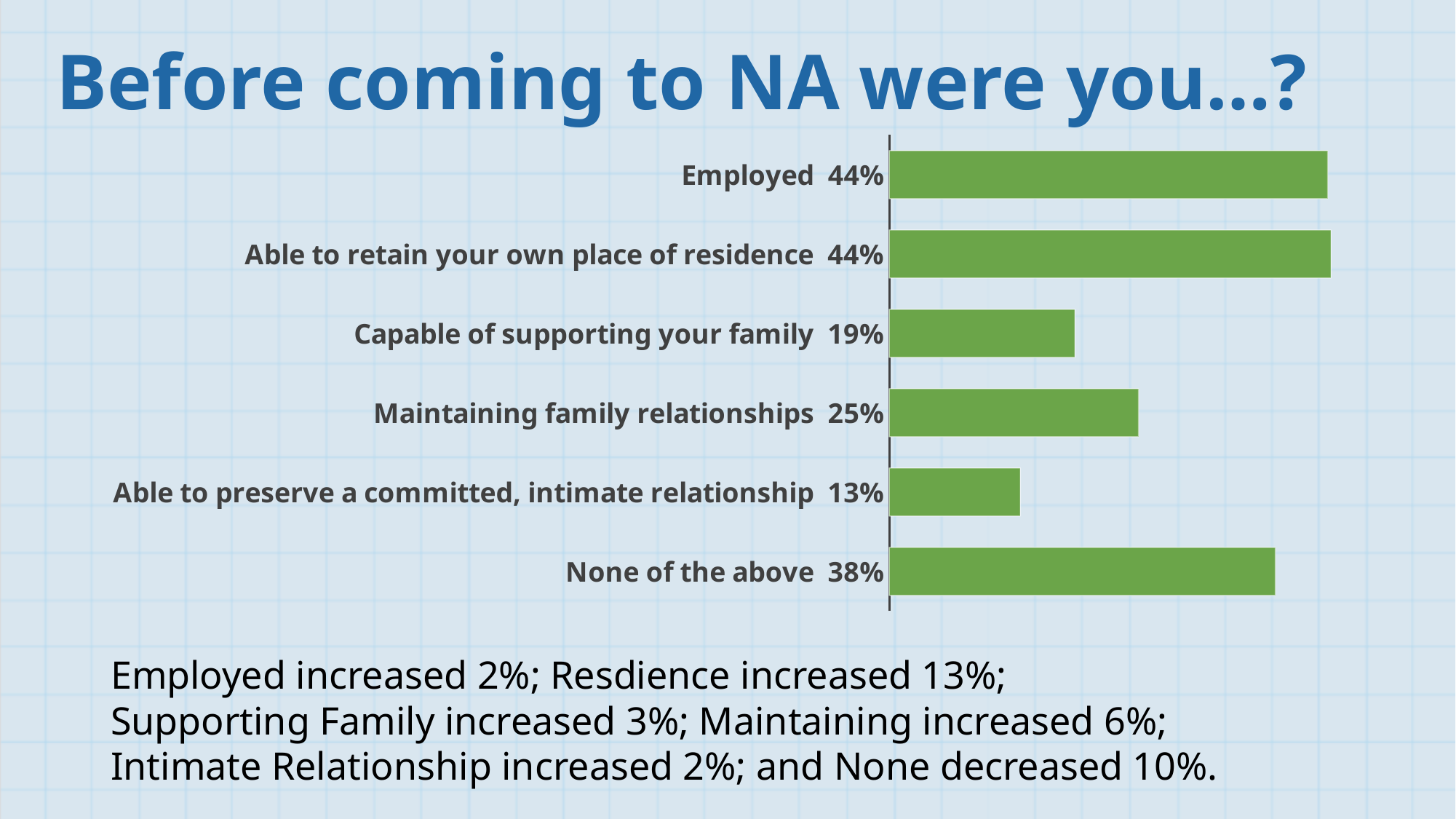
What value is shown for 'Capable of supporting your family'? 19% How many categories are shown in the chart? 6 Which is larger: 'Capable of supporting your family' or 'Able to preserve a committed, intimate relationship'? Capable of supporting your family What value is shown for 'None of the above'? 38% What is the difference between the value for 'Employed' and the value for 'None of the above'? 6% What is the difference between 'Maintaining family relationships' and 'Capable of supporting your family'? 6% What percentage is shown for 'Maintaining family relationships'? 25% What type of chart is shown on the slide? Bar chart Which category has the lowest value in the chart? Able to preserve a committed, intimate relationship What is the title of the slide? Before coming to NA were you...? What percentage of respondents were employed before coming to NA? 44% Which is larger: the value for 'None of the above' or the value for 'Maintaining family relationships'? None of the above